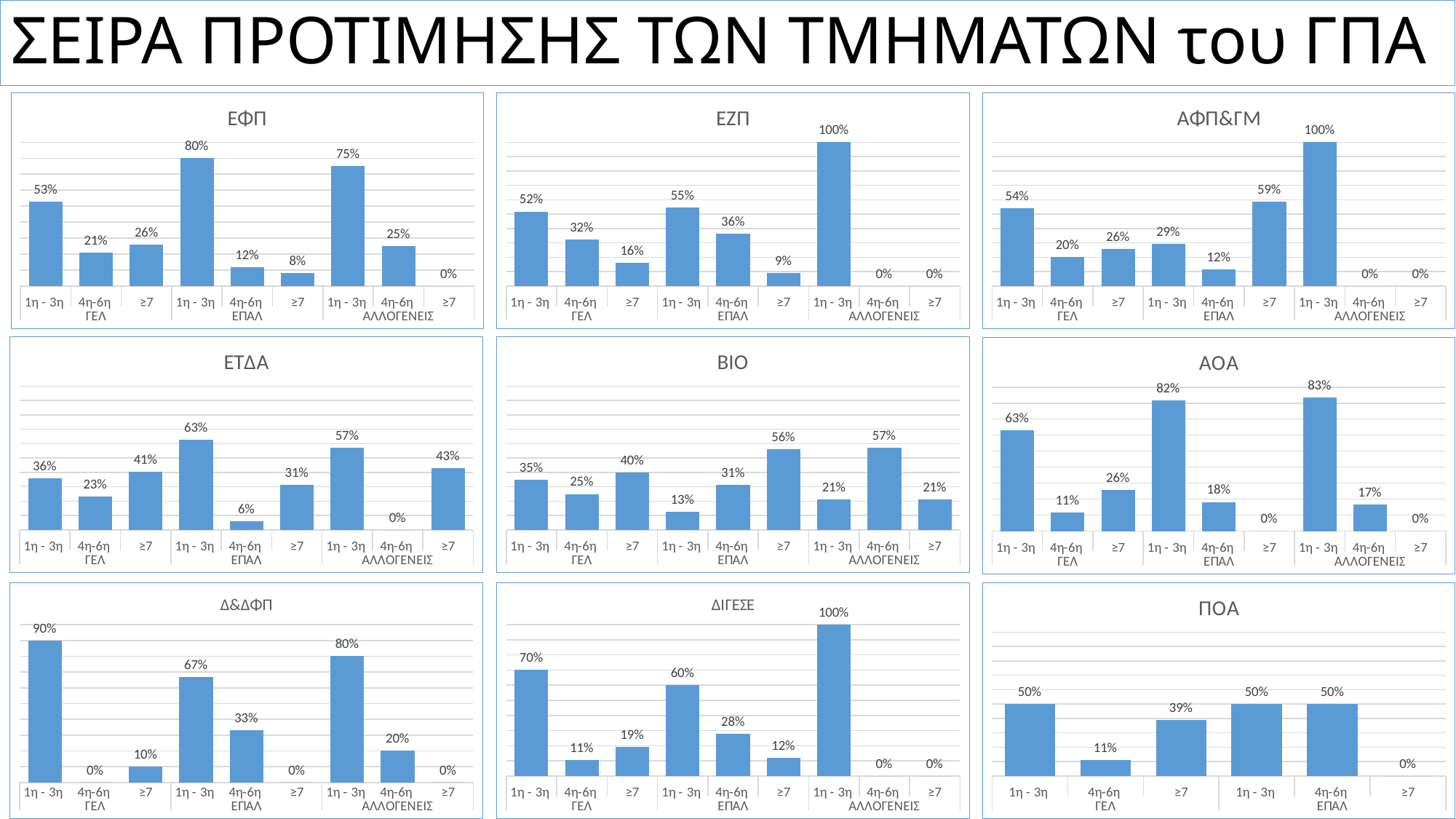
In the ΑΦΠ&ΓΜ chart, what is the value for ≥7 under ΕΠΑΛ? 59% What type of chart is the ΕΤΔΑ chart? Bar chart How many bars are plotted in the ΠΟΑ chart? 6 In the ΑΟΑ chart, what is the value for 4η-6η under ΓΕΛ? 11% How many charts are shown on the slide? 9 In the ΕΖΠ chart, which category has the highest value? 1η - 3η under ΑΛΛΟΓΕΝΕΙΣ In the Δ&ΔΦΠ chart, which category has the highest value? 1η - 3η under ΓΕΛ In the ΔΙΓΕΣΕ chart, what is the value for 4η-6η under ΕΠΑΛ? 28% In the ΕΤΔΑ chart, what is the difference between the 1η - 3η value under ΕΠΑΛ and the 1η - 3η value under ΓΕΛ? 27% In the ΠΟΑ chart, what is the value for ≥7 under ΓΕΛ? 39% In the ΕΦΠ chart, what is the value for 1η - 3η under ΕΠΑΛ? 80% In the ΒΙΟ chart, which is larger: the ≥7 value under ΕΠΑΛ or the ≥7 value under ΓΕΛ? ≥7 under ΕΠΑΛ